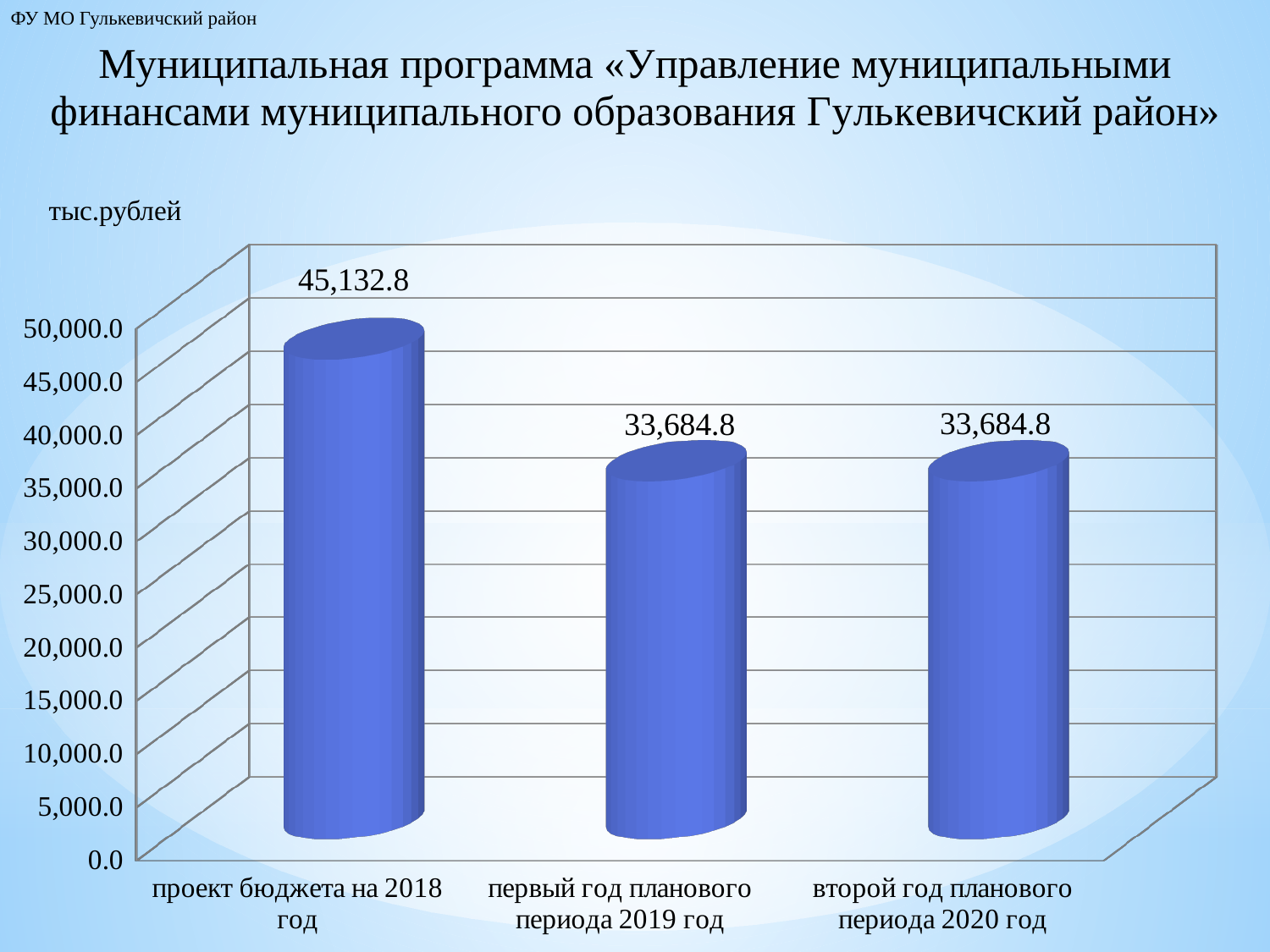
Do the values rise or fall from the 2018 category to the 2019 category? fall Which category has the highest value? проект бюджета на 2018 год What is the value for 'второй год планового периода 2020 год'? 33,684.8 Which is larger: the value for 'проект бюджета на 2018 год' or the value for 'второй год планового периода 2020 год'? проект бюджета на 2018 год Is the value for 'первый год планового периода 2019 год' greater or less than 40,000.0? less How many categories are shown on the chart? 3 What is the value for 'проект бюджета на 2018 год'? 45,132.8 What unit is indicated above the chart? тыс.рублей Is the value for 'проект бюджета на 2018 год' greater or less than 40,000.0? greater What kind of chart is shown on the slide? bar chart What is the value for 'первый год планового периода 2019 год'? 33,684.8 What is the difference between the value for 'проект бюджета на 2018 год' and the value for 'первый год планового периода 2019 год'? 11,448.0